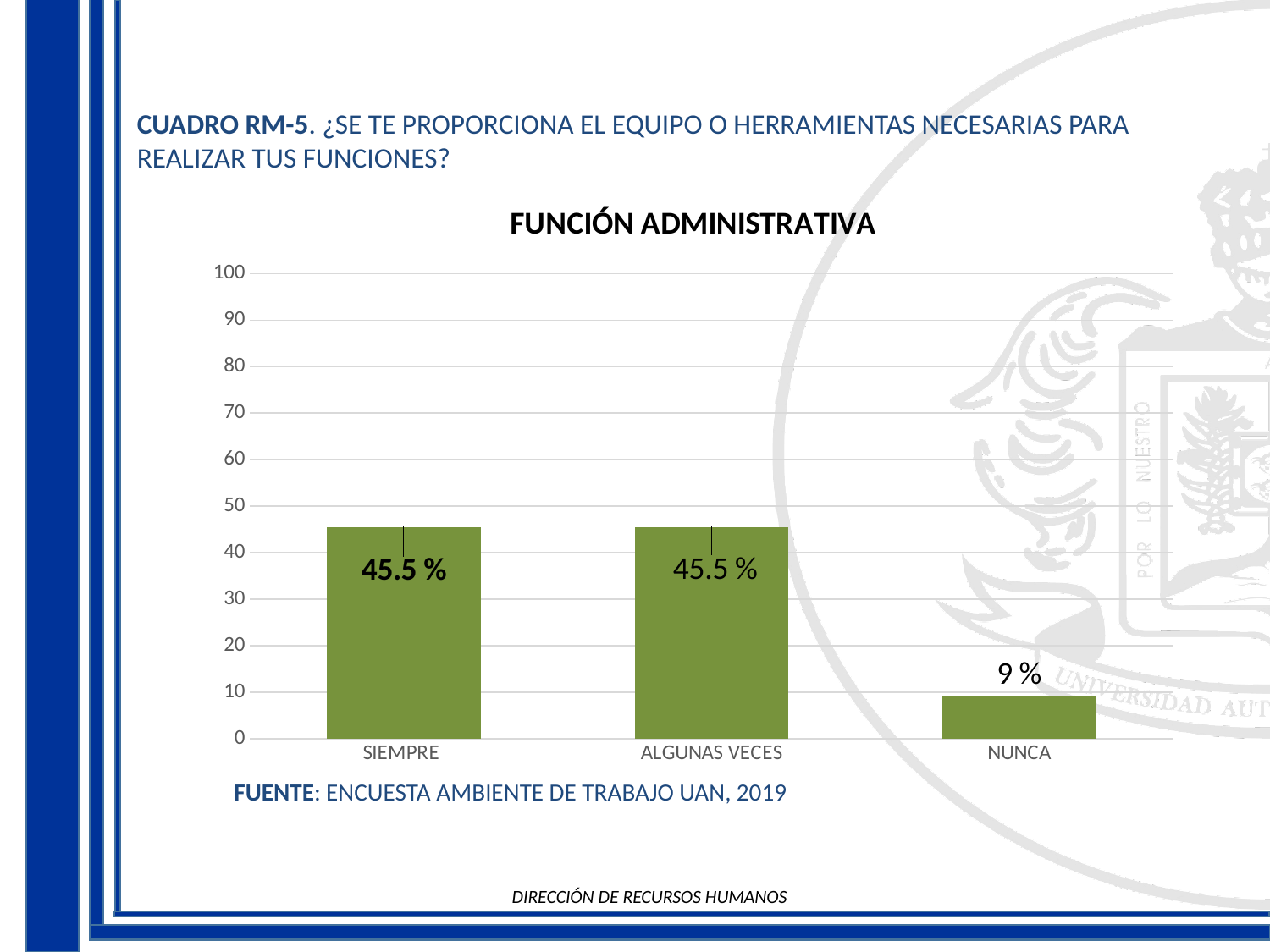
What is the value for SIEMPRE? 45.5 % Is the value for SIEMPRE greater or less than 40? greater How many categories are shown on the x axis? 3 Which category has the lowest value? NUNCA Is the value for NUNCA greater or less than 10? less What kind of chart is shown? bar chart What is the value for ALGUNAS VECES? 45.5 % What is the title of the chart? FUNCIÓN ADMINISTRATIVA What is the value for NUNCA? 9 % Which is larger, the value for ALGUNAS VECES or the value for NUNCA? ALGUNAS VECES What is the maximum value shown on the y axis? 100 What is the difference between the values for SIEMPRE and NUNCA? 36.5 %